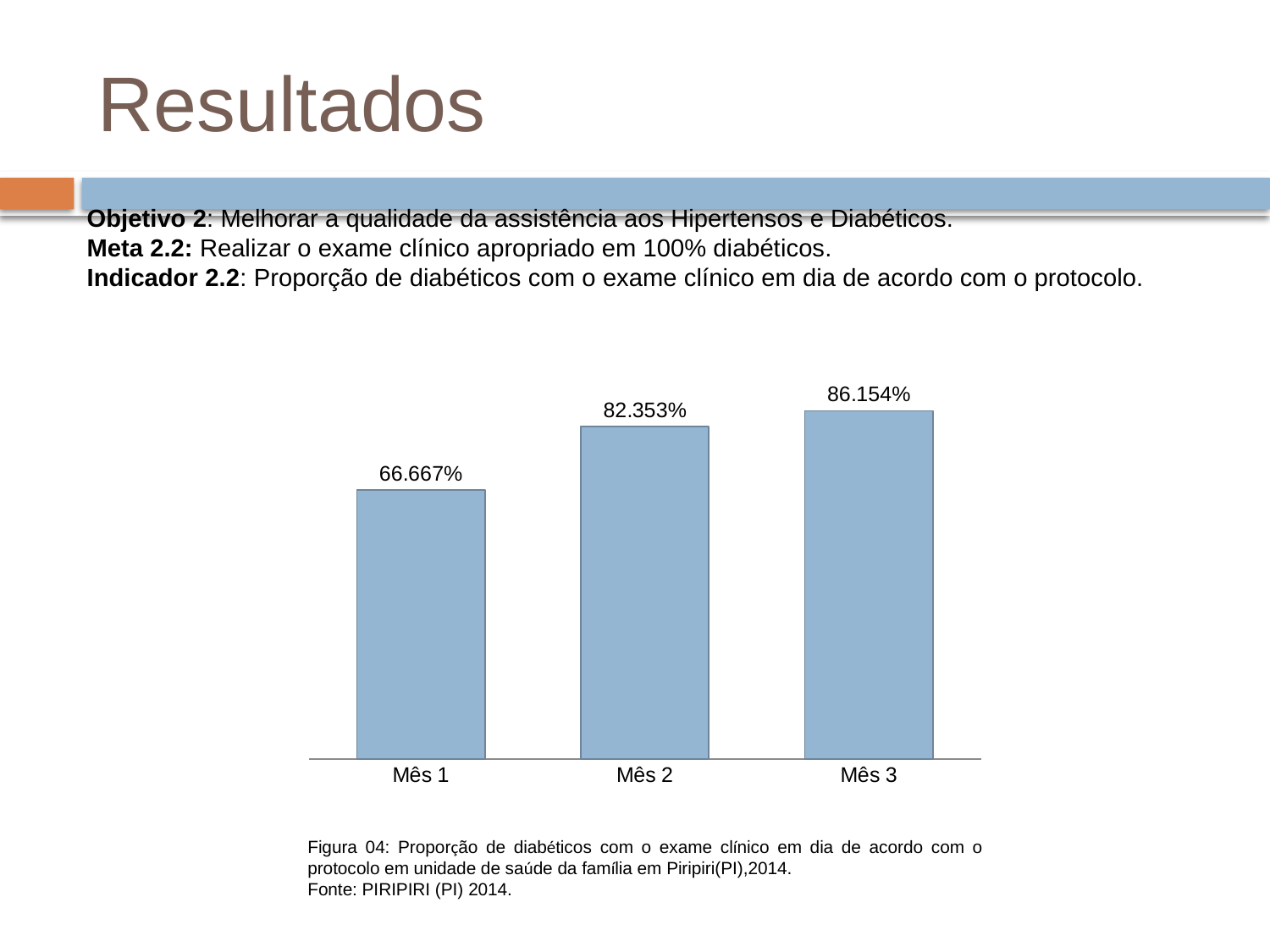
What kind of chart is shown on the slide? Bar chart Which month has the highest value? Mês 3 What is the figure number given in the caption below the chart? Figura 04 What is the difference between the values for Mês 2 and Mês 1? 15.686% What is the difference between the values for Mês 3 and Mês 2? 3.801% Which is larger, the value for Mês 1 or the value for Mês 2? Mês 2 How many months are shown on the x axis? 3 Do the values rise or fall from Mês 1 to Mês 3? Rise What is the value for Mês 3? 86.154% Which month has the lowest value? Mês 1 What is the value for Mês 1? 66.667% What is the value for Mês 2? 82.353%